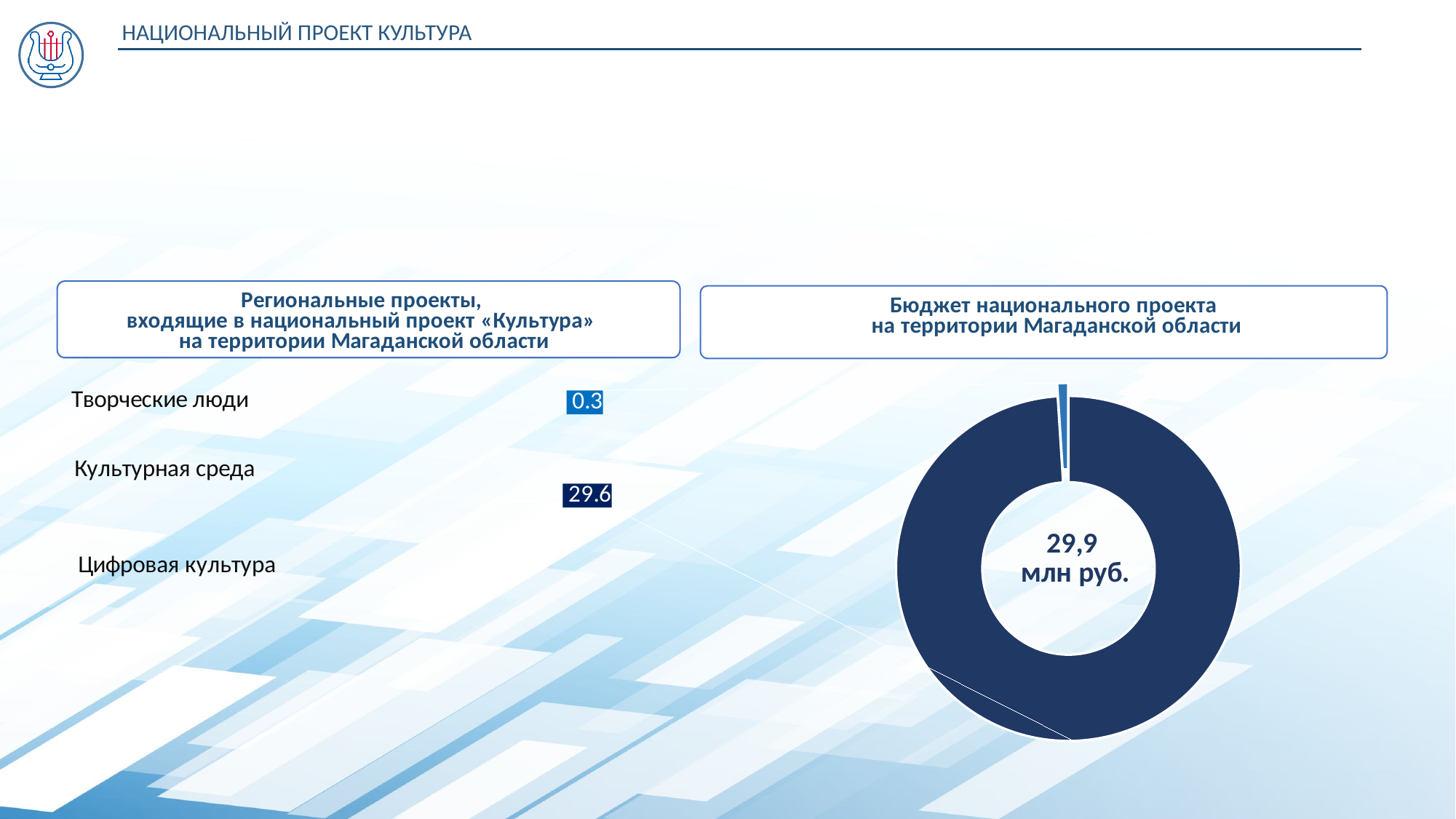
What is the value for Культурная среда in the chart? 29.6 What kind of chart is shown on the slide? doughnut (pie) chart Is the value for Культурная среда greater or less than 20? greater Which is larger, the value for Культурная среда or the value for Творческие люди? Культурная среда What is the value for Творческие люди in the chart? 0.3 What is the title of the chart on the right side of the slide? Бюджет национального проекта на территории Магаданской области What total budget is shown in the centre of the doughnut chart? 29,9 млн руб. Which regional project has the largest share of the budget in the chart? Культурная среда What is the difference between the values for Культурная среда and Творческие люди? 29.3 How many regional projects are listed next to the chart? 3